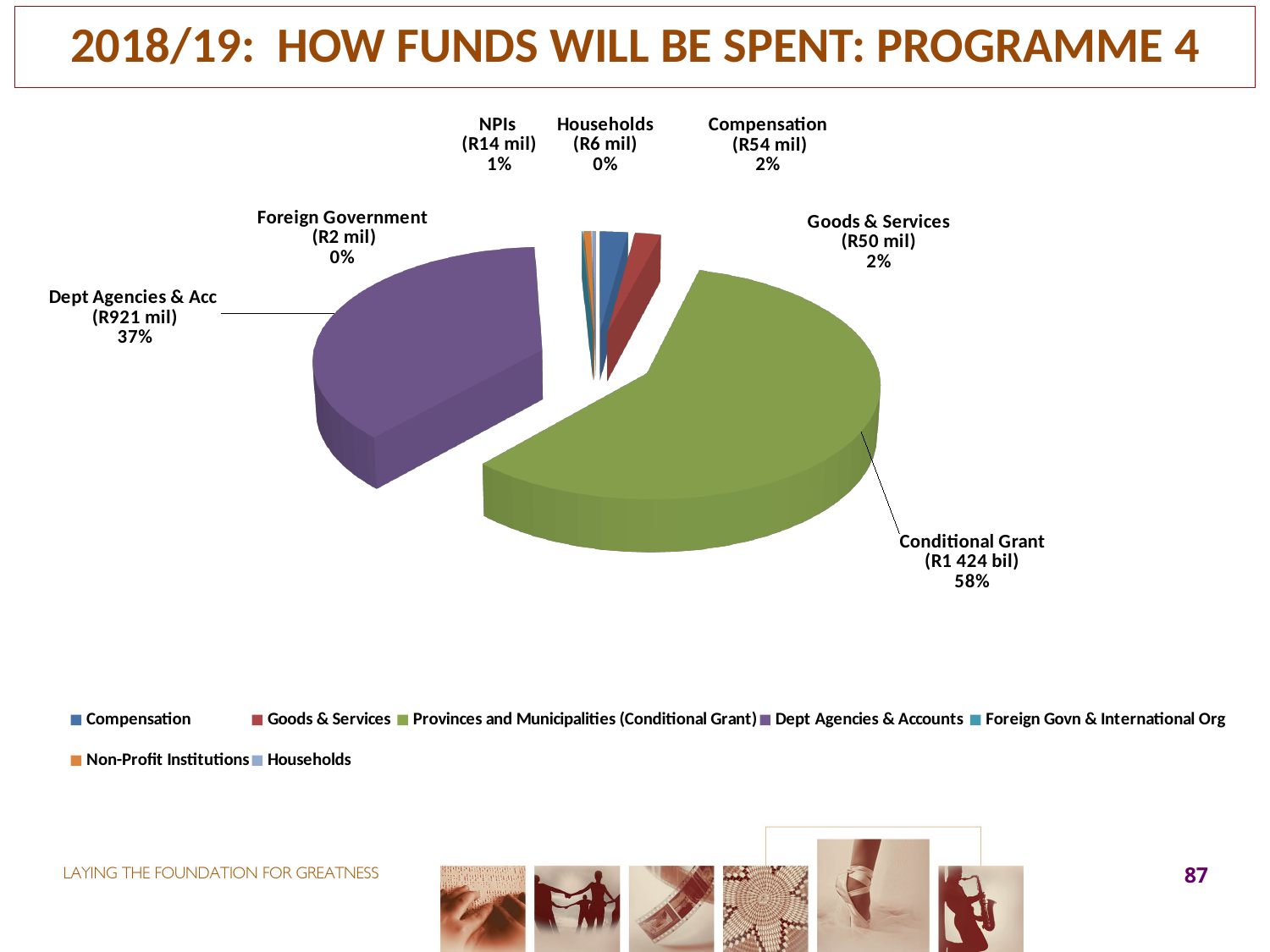
What kind of chart is shown on the slide? Pie chart Which category has the largest slice of the pie? Conditional Grant What share of the pie does Dept Agencies & Acc represent? 37% What amount is shown for Goods & Services? R50 mil What is the title of the slide? 2018/19: HOW FUNDS WILL BE SPENT: PROGRAMME 4 What share of the pie does Conditional Grant represent? 58% Which is larger, the amount for Compensation or the amount for Goods & Services? Compensation Which category has the smallest amount shown? Foreign Government (R2 mil) How many categories are labelled on the pie chart? 7 What amount is shown for NPIs? R14 mil What amount is shown for Compensation? R54 mil What is the difference in percentage points between the Conditional Grant share and the Dept Agencies & Acc share? 21 percentage points